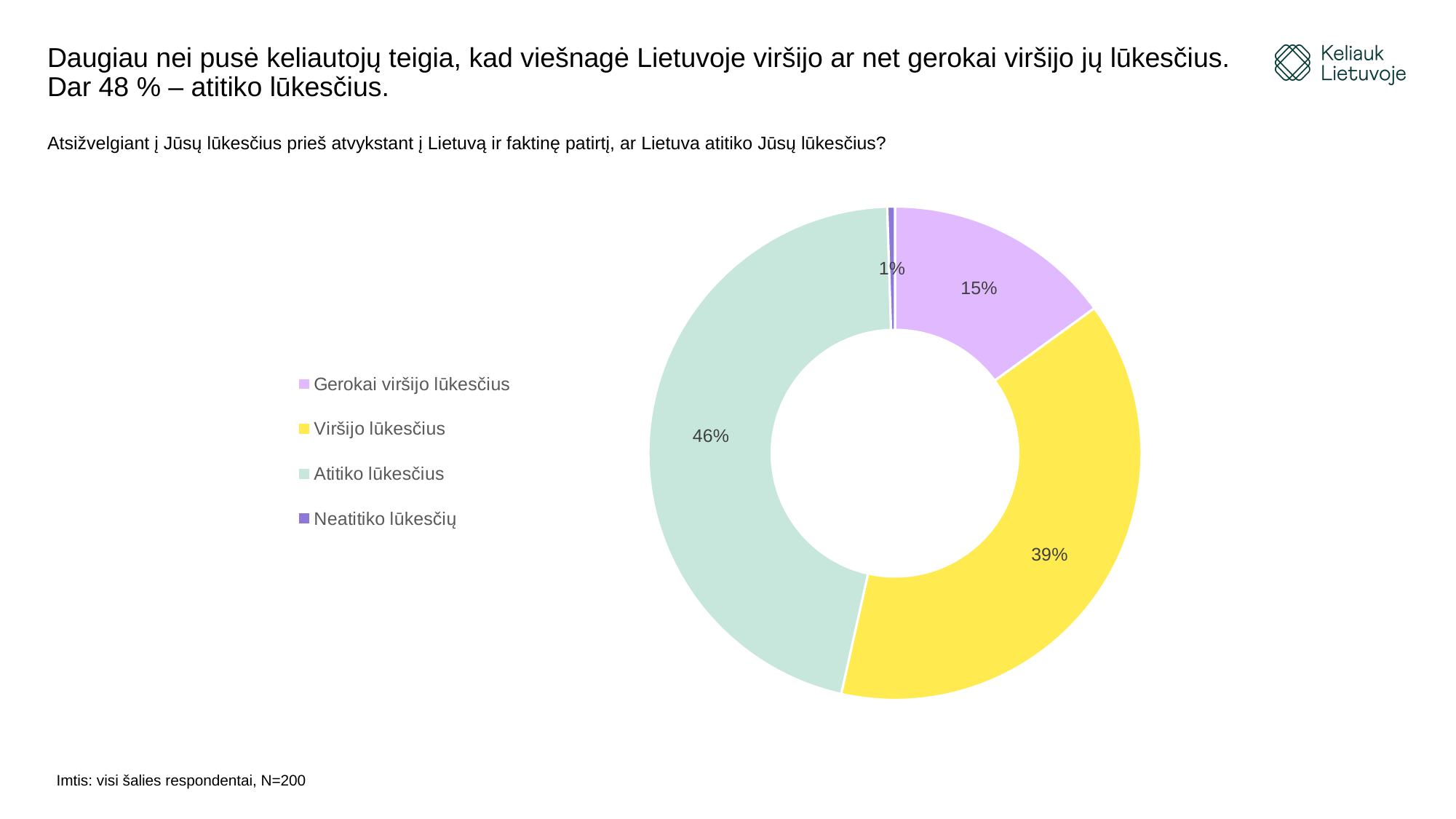
Which category has the largest share of the pie? Atitiko lūkesčius What share of respondents answered "Viršijo lūkesčius"? 39% What is the difference in percentage points between "Atitiko lūkesčius" and "Viršijo lūkesčius"? 7 percentage points What kind of chart is shown on the slide? Pie chart (doughnut) Which colour represents "Atitiko lūkesčius" in the legend? Light green What is the combined share of "Gerokai viršijo lūkesčius" and "Viršijo lūkesčius"? 54% Which category has the smallest share of the pie? Neatitiko lūkesčių How many categories does the chart show? 4 What share of respondents answered "Atitiko lūkesčius"? 46% Which is larger: the share for "Viršijo lūkesčius" or for "Gerokai viršijo lūkesčius"? Viršijo lūkesčius What share of respondents answered "Neatitiko lūkesčių"? 1% What share of respondents answered "Gerokai viršijo lūkesčius"? 15%